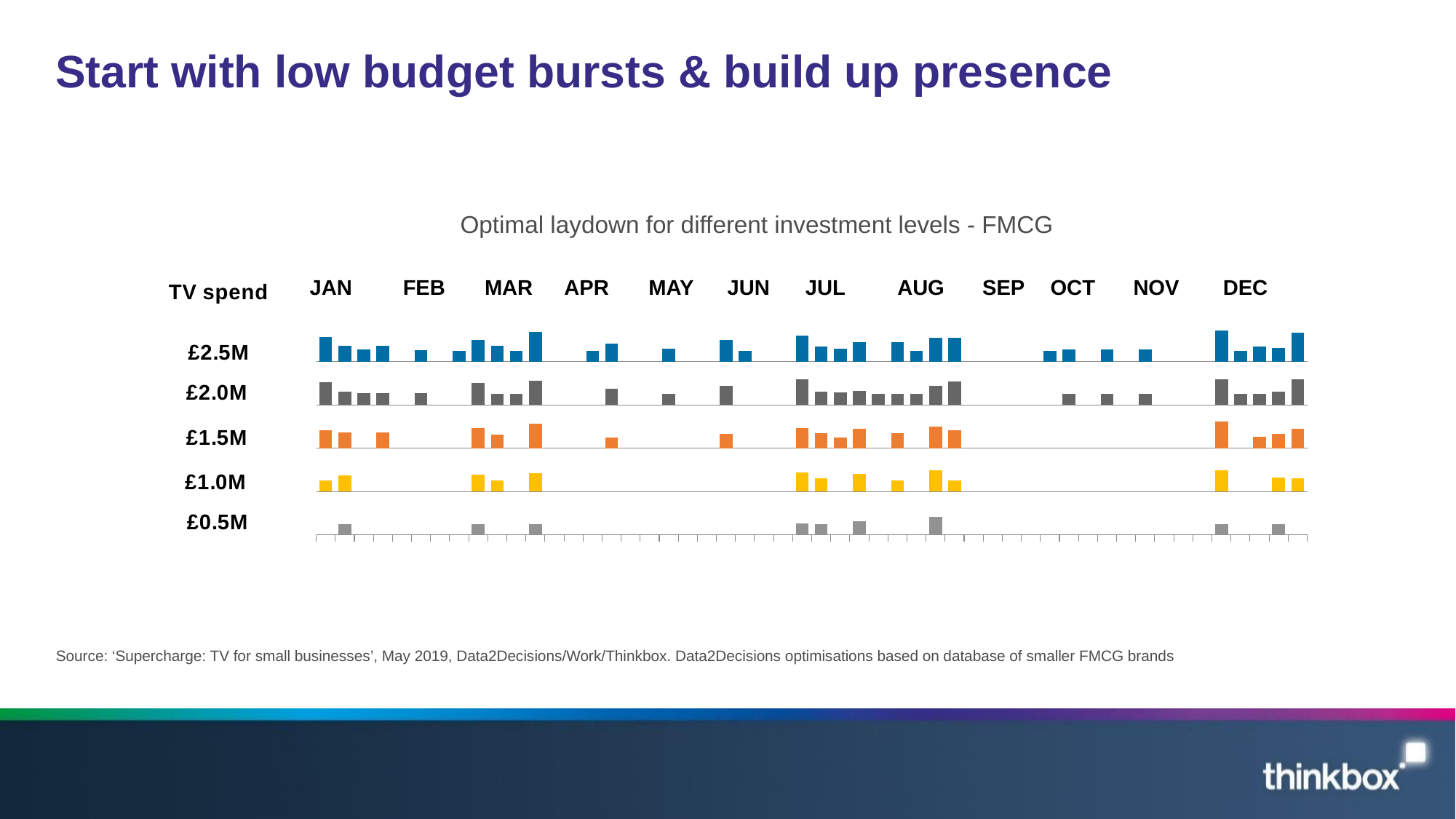
What colour are the bars for the £1.0M TV spend level? Yellow What kind of chart is shown on the slide? Bar chart Which TV spend level has bars in the most weeks across the year? £2.5M Does the £1.0M TV spend row have any bars in May? No What is the highest TV spend level shown in the chart? £2.5M How many TV spend levels are plotted as separate rows in the chart? 5 Which TV spend level has the fewest bars plotted across the year? £0.5M What is the lowest TV spend level shown in the chart? £0.5M How many months are shown along the x axis of the chart? 12 What is the title of the chart? Optimal laydown for different investment levels - FMCG